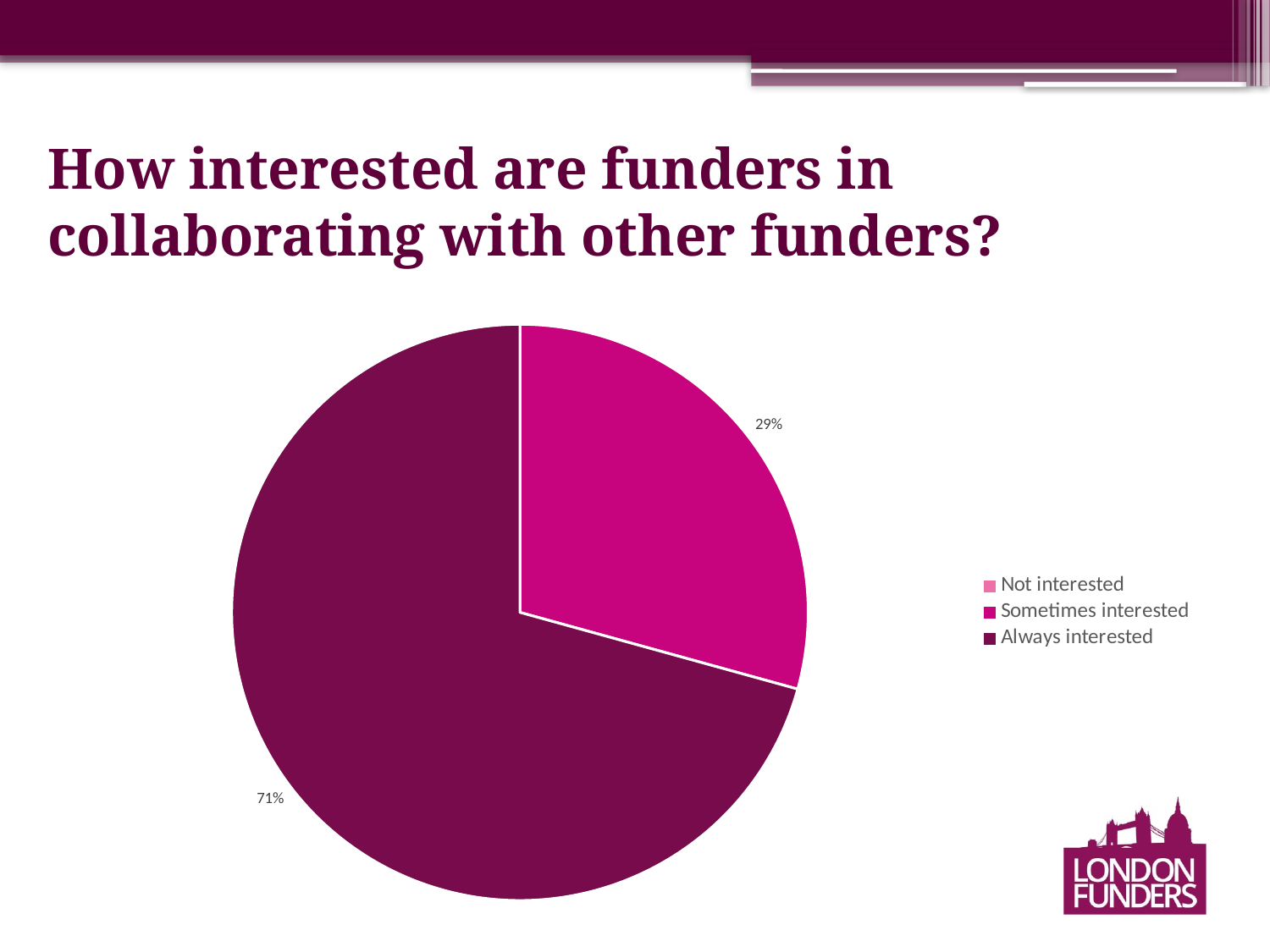
How many slices of the pie have a percentage label printed? 2 Is the 'Always interested' slice more or less than half of the pie? more What kind of chart is shown on the slide? pie chart What percentage of the pie is labelled for the 'Always interested' slice? 71% What is the title of the slide containing the pie chart? How interested are funders in collaborating with other funders? Which legend entry is shown in the darkest colour? Always interested Which is larger, the 'Sometimes interested' slice or the 'Always interested' slice? Always interested What is the difference in percentage points between the 'Always interested' and 'Sometimes interested' slices? 42 percentage points How many entries does the legend list? 3 What percentage of the pie is labelled for the 'Sometimes interested' slice? 29% Which category has the largest slice of the pie? Always interested